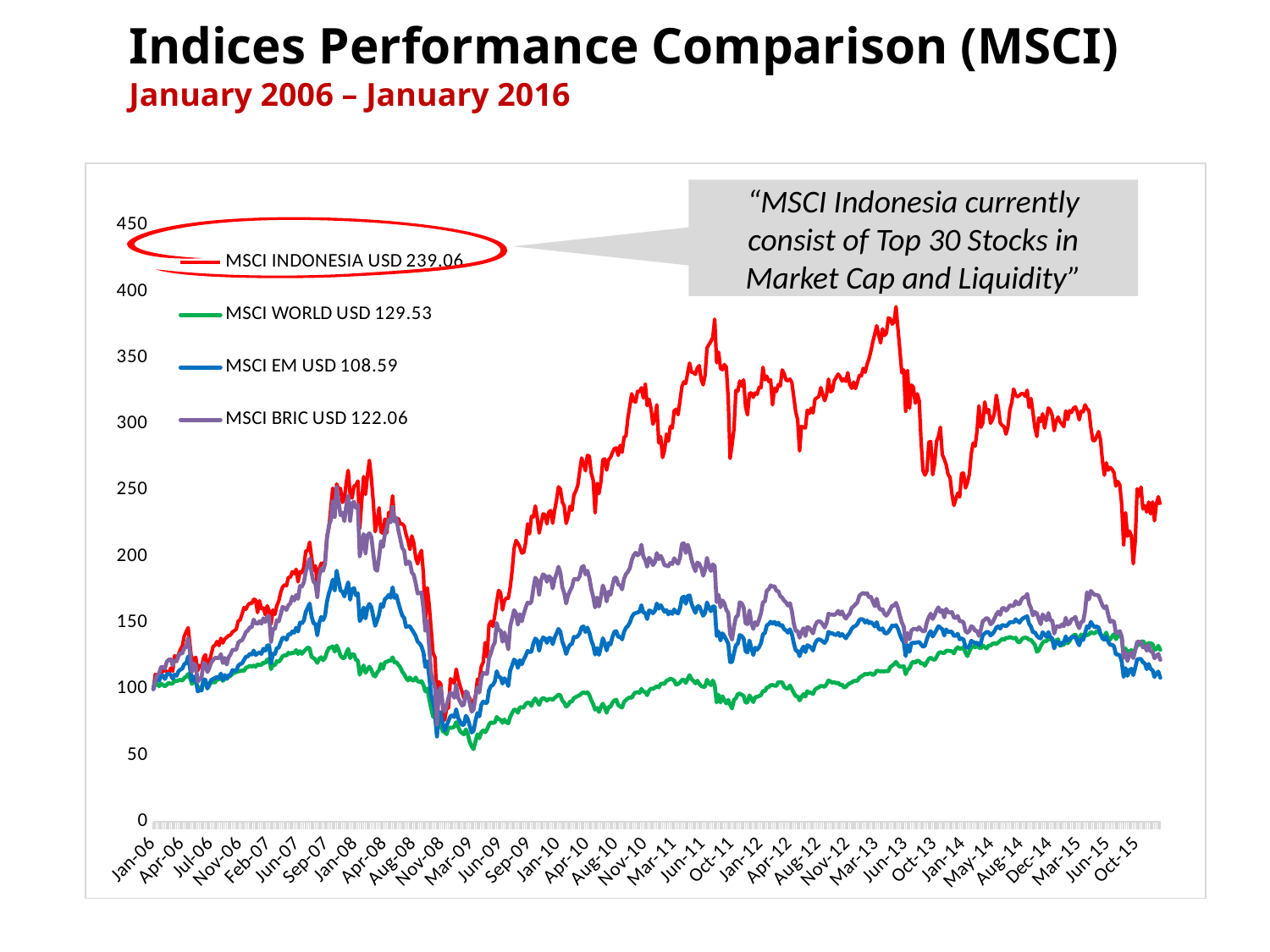
Is the value of the MSCI WORLD USD line around Mar-09 greater or less than 100? less What value is shown in the legend for MSCI INDONESIA USD? 239.06 What colour is the MSCI INDONESIA USD line? red Which series has the lowest value shown in the legend? MSCI EM USD Which series has the highest value shown in the legend? MSCI INDONESIA USD What kind of chart is shown on the slide? line chart How many series does the legend list? 4 What value is shown in the legend for MSCI BRIC USD? 122.06 What value is shown in the legend for MSCI WORLD USD? 129.53 Which has the larger legend value, MSCI BRIC USD or MSCI EM USD? MSCI BRIC USD What is the difference between the legend values for MSCI INDONESIA USD and MSCI WORLD USD? 109.53 What value is shown in the legend for MSCI EM USD? 108.59